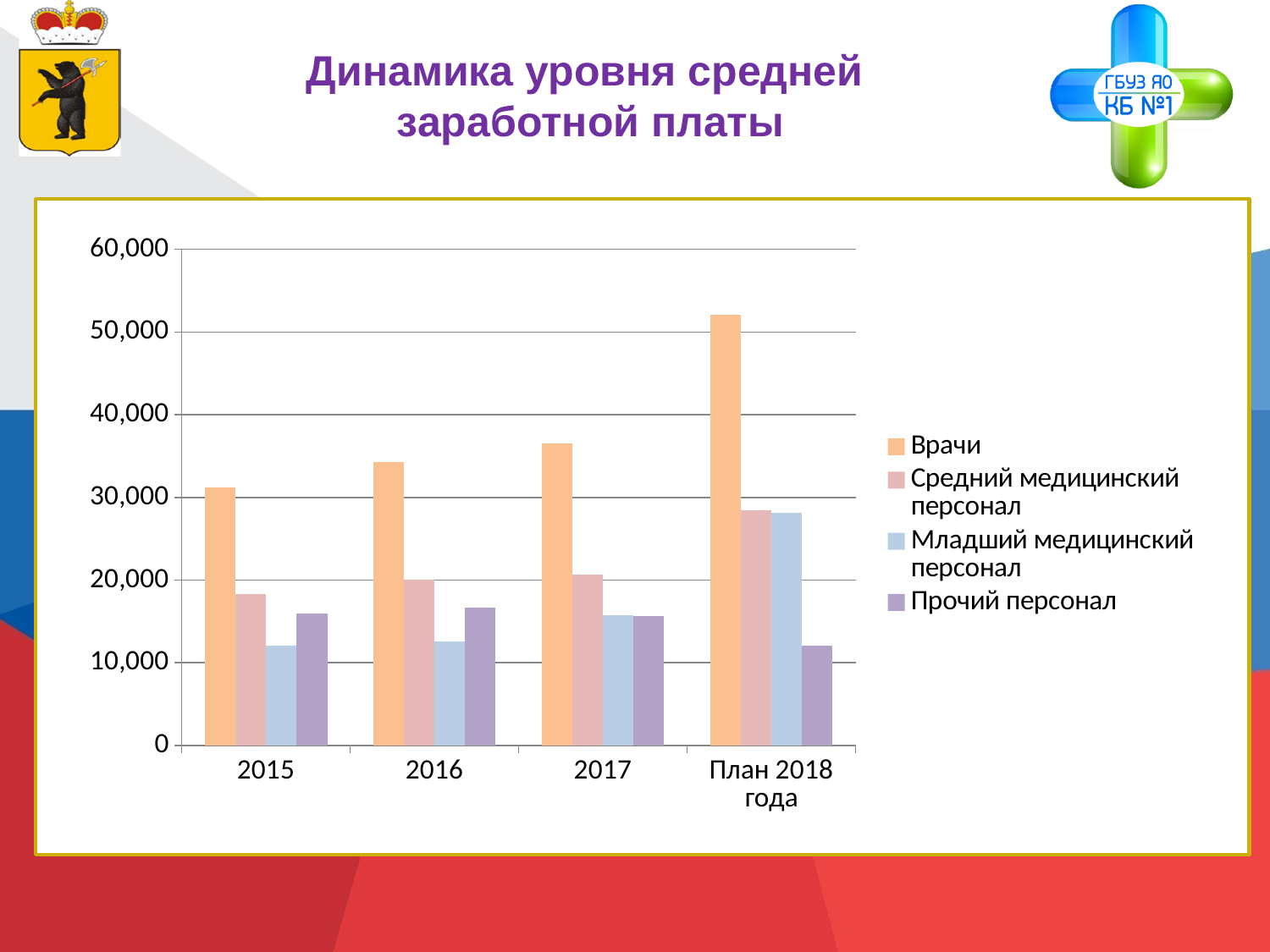
Is the value for Прочий персонал in План 2018 года greater or less than 20,000? less How many categories are shown on the x axis? 4 In which category is the value for Прочий персонал the lowest? План 2018 года In which category is the value for Врачи the highest? План 2018 года How many series does the legend list? 4 Is the value for Врачи in План 2018 года greater or less than 50,000? greater What kind of chart is shown on the slide? bar chart Is the value for Младший медицинский персонал in 2015 greater or less than 20,000? less Do the values for Врачи rise or fall from 2015 to План 2018 года? rise For Младший медицинский персонал, which is larger: the value in 2016 or in 2017? 2017 In 2016, which is larger: Врачи or Средний медицинский персонал? Врачи